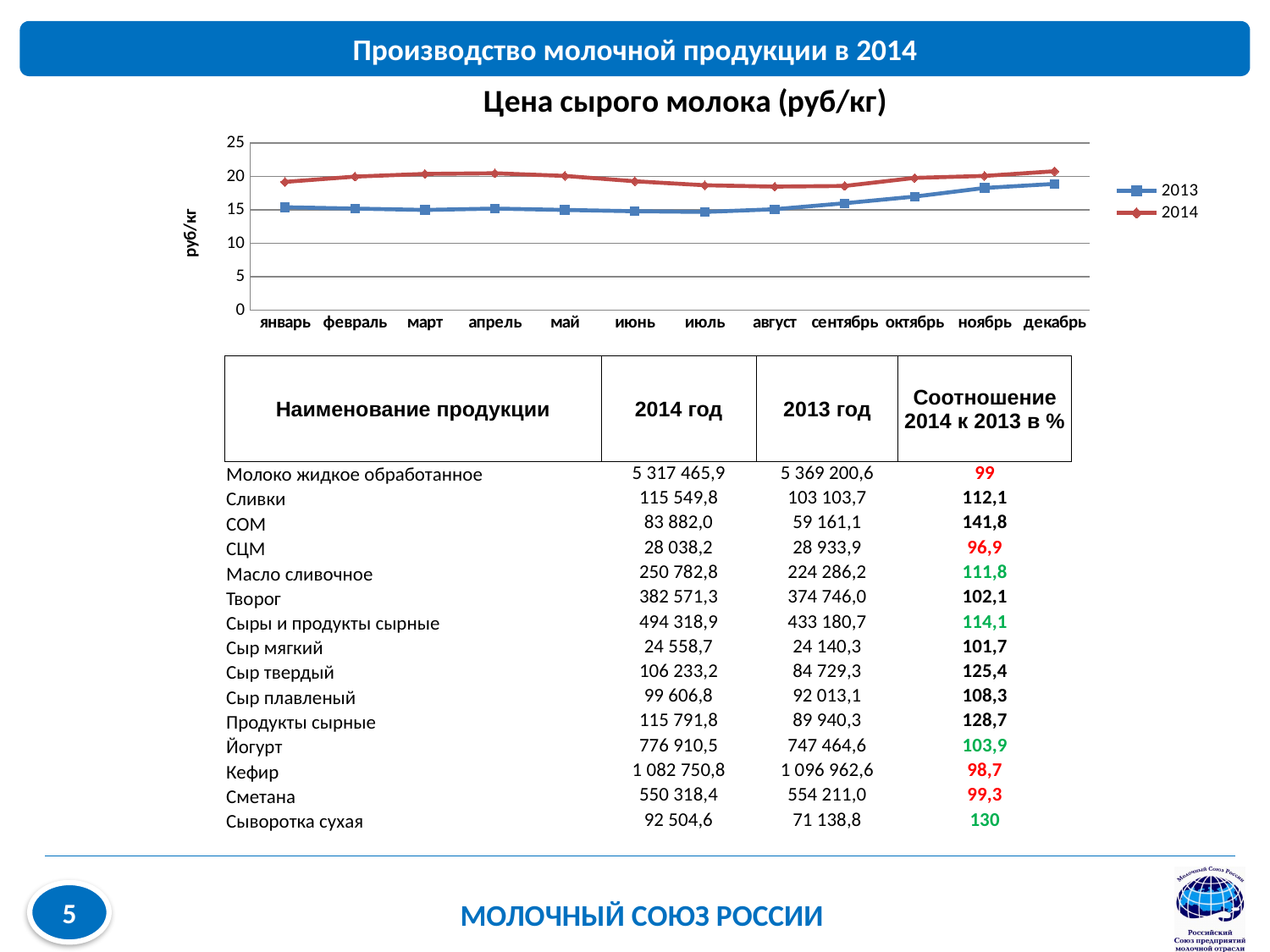
Which series are listed in the chart legend? 2013 and 2014 Is the value for 2013 in декабрь greater or less than 15? greater Is the value for 2014 in август greater or less than 20? less Is the value for 2014 in январь greater or less than 15? greater What kind of chart is shown on the slide? line chart How many series does the chart legend list? 2 Does the 2014 series rise or fall from апрель to август? fall In июль, which series has the higher value, 2013 or 2014? 2014 What is the title of the chart? Цена сырого молока (руб/кг) How many months are plotted along the x axis of the chart? 12 Does the 2013 series rise or fall from август to декабрь? rise